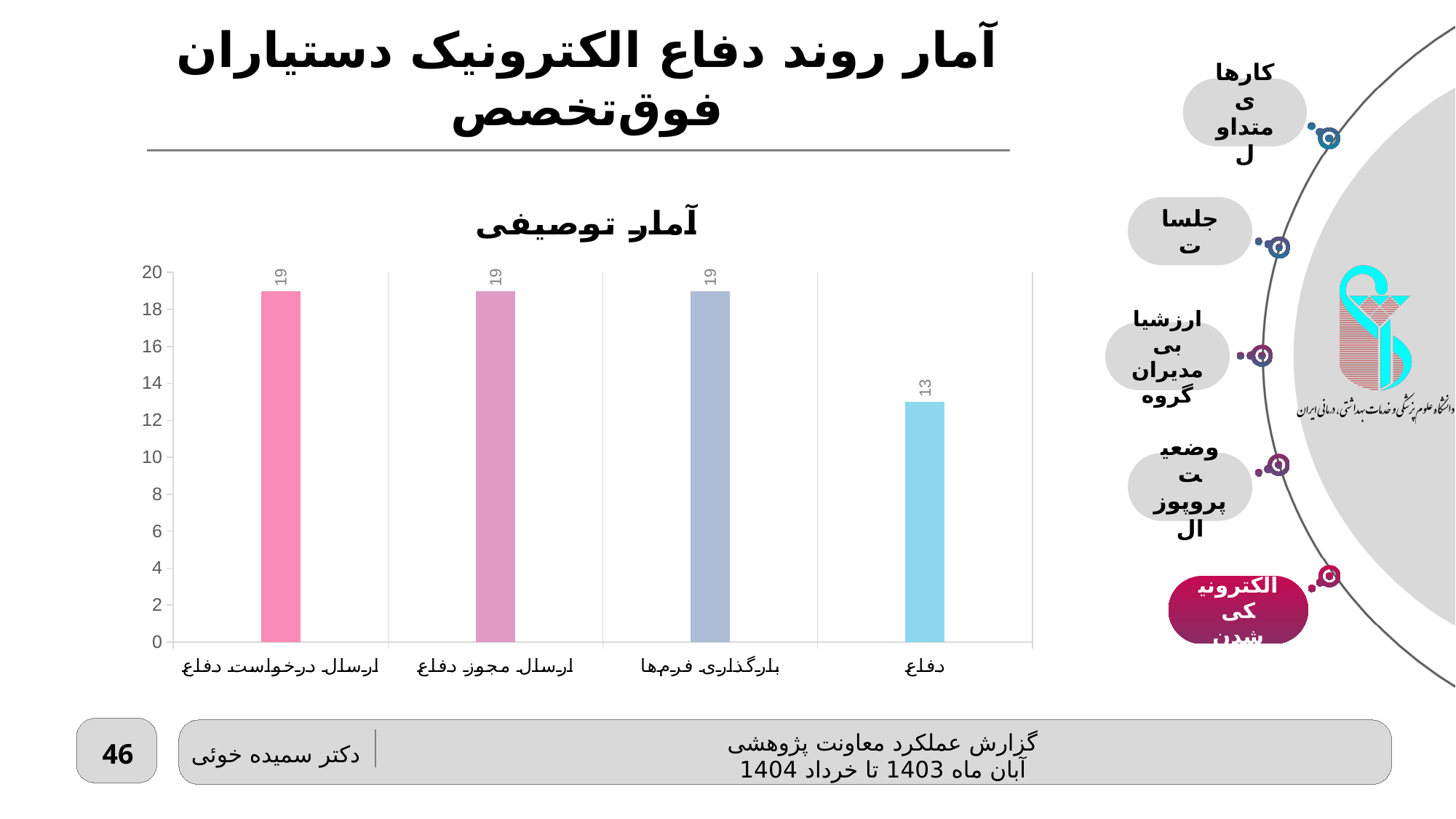
What is the title of the chart? آمار توصیفی Which category has the lowest value? دفاع What is the value for ارسال درخواست دفاع? 19 How many categories are plotted in the chart? 4 What is the highest value shown on the vertical axis? 20 Is the value for دفاع greater or less than 10? greater What is the value for بارگذاری فرم‌ها? 19 What is the value for دفاع? 13 What is the difference between the values for ارسال مجوز دفاع and دفاع? 6 Which is larger, the value for بارگذاری فرم‌ها or the value for دفاع? بارگذاری فرم‌ها What type of chart is shown on the slide? bar chart What is the value for ارسال مجوز دفاع? 19